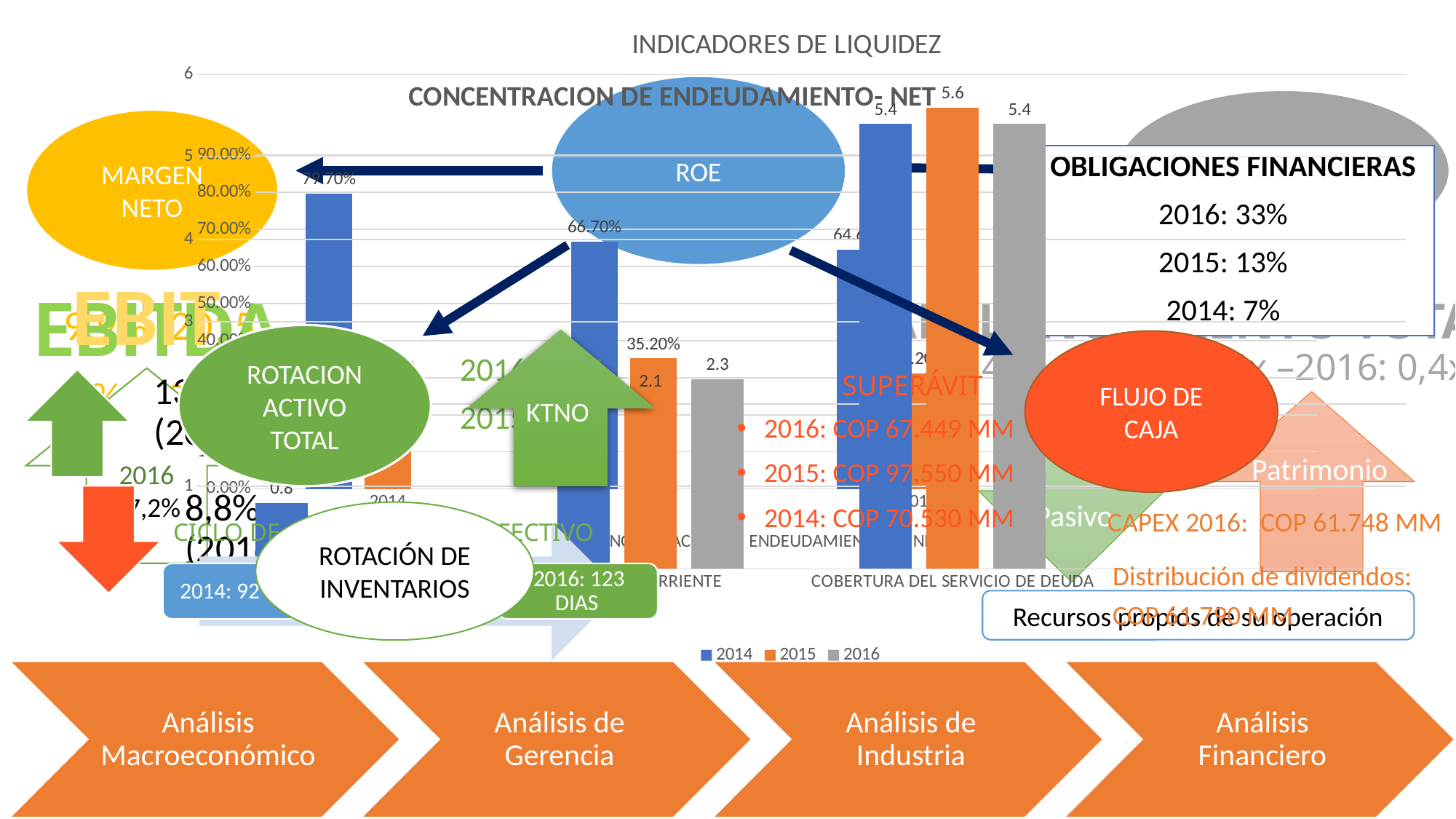
Which years are listed in the legend of the INDICADORES DE LIQUIDEZ chart? 2014, 2015, 2016 In the INDICADORES DE LIQUIDEZ chart, what is the difference between the 2015 and 2014 values for COBERTURA DEL SERVICIO DE DEUDA? 0.2 In the INDICADORES DE LIQUIDEZ chart, what is the 2014 value for COBERTURA DEL SERVICIO DE DEUDA? 5.4 In the INDICADORES DE LIQUIDEZ chart, what is the 2015 value for COBERTURA DEL SERVICIO DE DEUDA? 5.6 What kind of chart is the INDICADORES DE LIQUIDEZ chart? bar chart In the CONCENTRACION DE ENDEUDAMIENTO- NET chart, what is the value printed on the tallest blue bar? 79.70% In the INDICADORES DE LIQUIDEZ chart, is the 2015 value for COBERTURA DEL SERVICIO DE DEUDA greater or less than 5? greater In the INDICADORES DE LIQUIDEZ chart, which is larger for COBERTURA DEL SERVICIO DE DEUDA, the 2015 value or the 2016 value? 2015 What is the title of the chart at the top of the slide? INDICADORES DE LIQUIDEZ How many series does the legend of the INDICADORES DE LIQUIDEZ chart list? 3 In the INDICADORES DE LIQUIDEZ chart, which year has the highest value for COBERTURA DEL SERVICIO DE DEUDA? 2015 In the INDICADORES DE LIQUIDEZ chart, what is the 2016 value for COBERTURA DEL SERVICIO DE DEUDA? 5.4